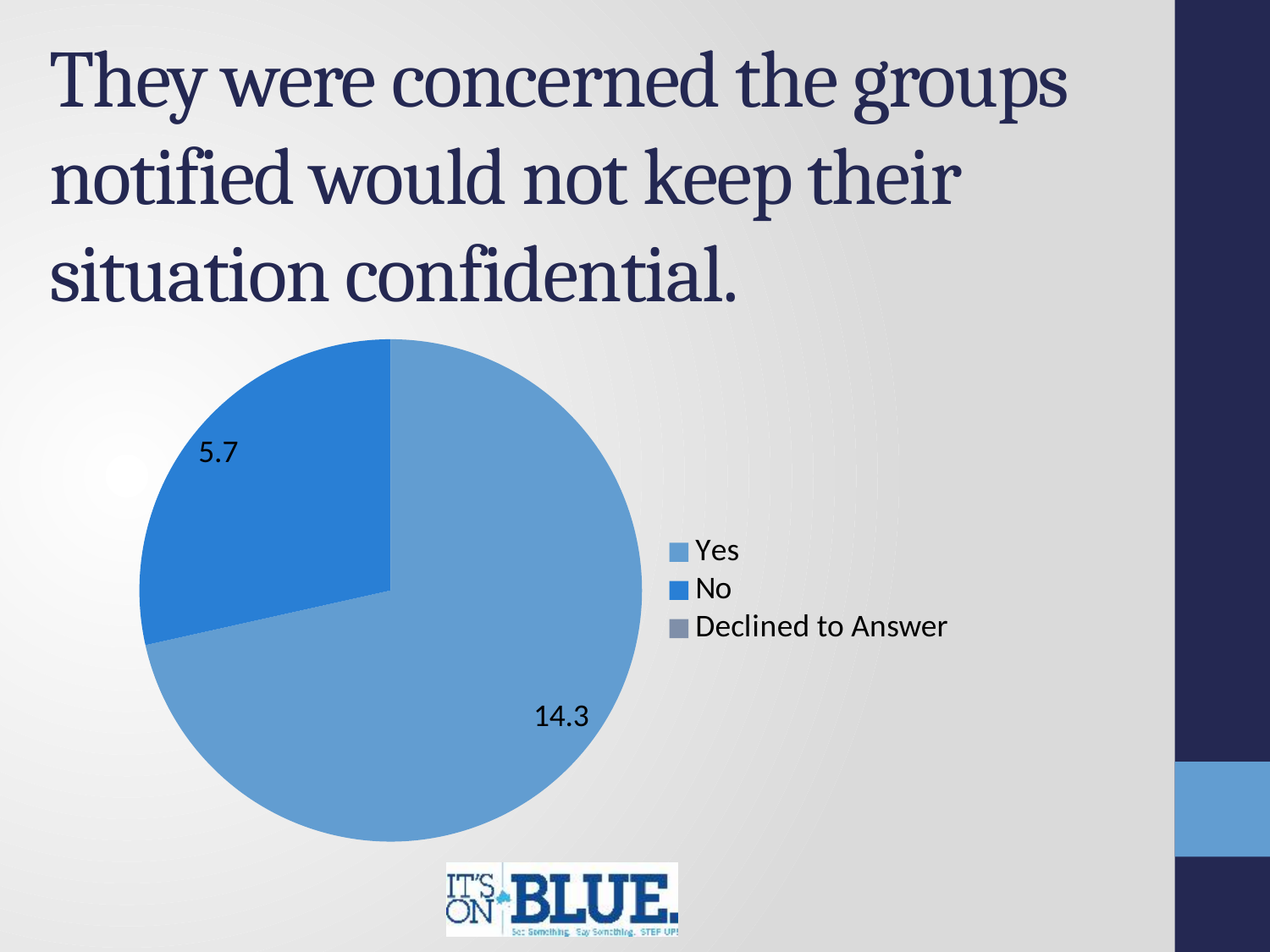
What value is shown for the Yes slice of the pie chart? 14.3 Which is larger in the pie chart, the Yes value or the No value? Yes Which category has the largest slice in the pie chart? Yes How many entries does the chart's legend list? 3 Is the Yes value in the pie chart greater or less than 10? greater What kind of chart is shown on the slide? Pie chart What value is shown for the No slice of the pie chart? 5.7 What is the third entry listed in the chart's legend? Declined to Answer What is the difference between the Yes value and the No value in the pie chart? 8.6 How many slices with data labels are visible in the pie chart? 2 Which of the two labelled slices, Yes or No, has the smaller value? No